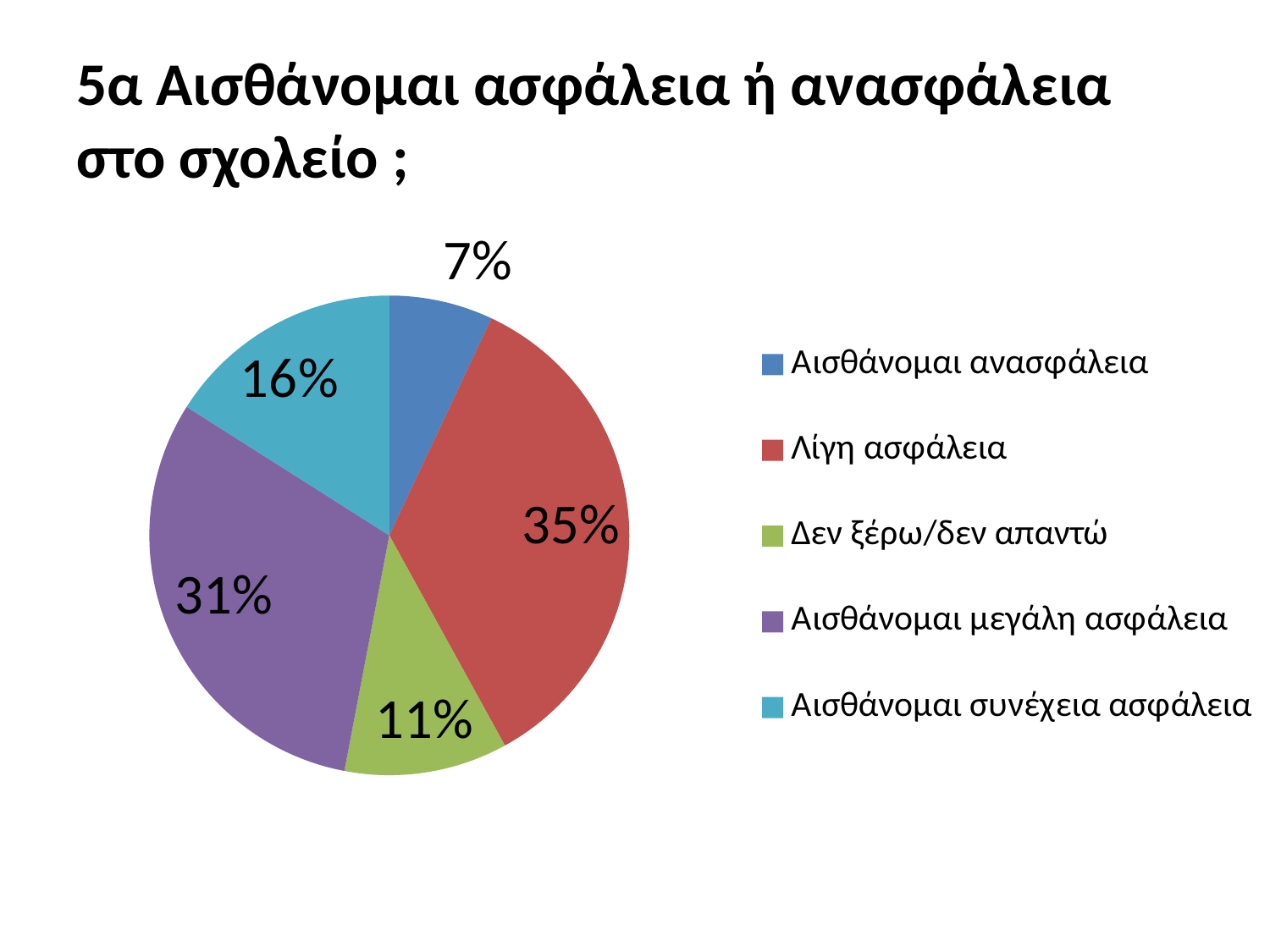
What percentage is shown for "Δεν ξέρω/δεν απαντώ"? 11% Which is larger: "Αισθάνομαι συνέχεια ασφάλεια" or "Δεν ξέρω/δεν απαντώ"? Αισθάνομαι συνέχεια ασφάλεια What percentage of the pie is labelled "Λίγη ασφάλεια"? 35% What is the value shown for "Αισθάνομαι μεγάλη ασφάλεια"? 31% How many categories does the pie chart show? 5 What colour is the slice for "Αισθάνομαι μεγάλη ασφάλεια"? Purple Which category has the largest slice of the pie? Λίγη ασφάλεια Which category has the smallest slice of the pie? Αισθάνομαι ανασφάλεια What type of chart is shown on the slide? Pie chart What is the difference in percentage points between "Λίγη ασφάλεια" and "Αισθάνομαι μεγάλη ασφάλεια"? 4 percentage points What is the value for "Αισθάνομαι συνέχεια ασφάλεια"? 16% What share does "Αισθάνομαι ανασφάλεια" have in the pie chart? 7%